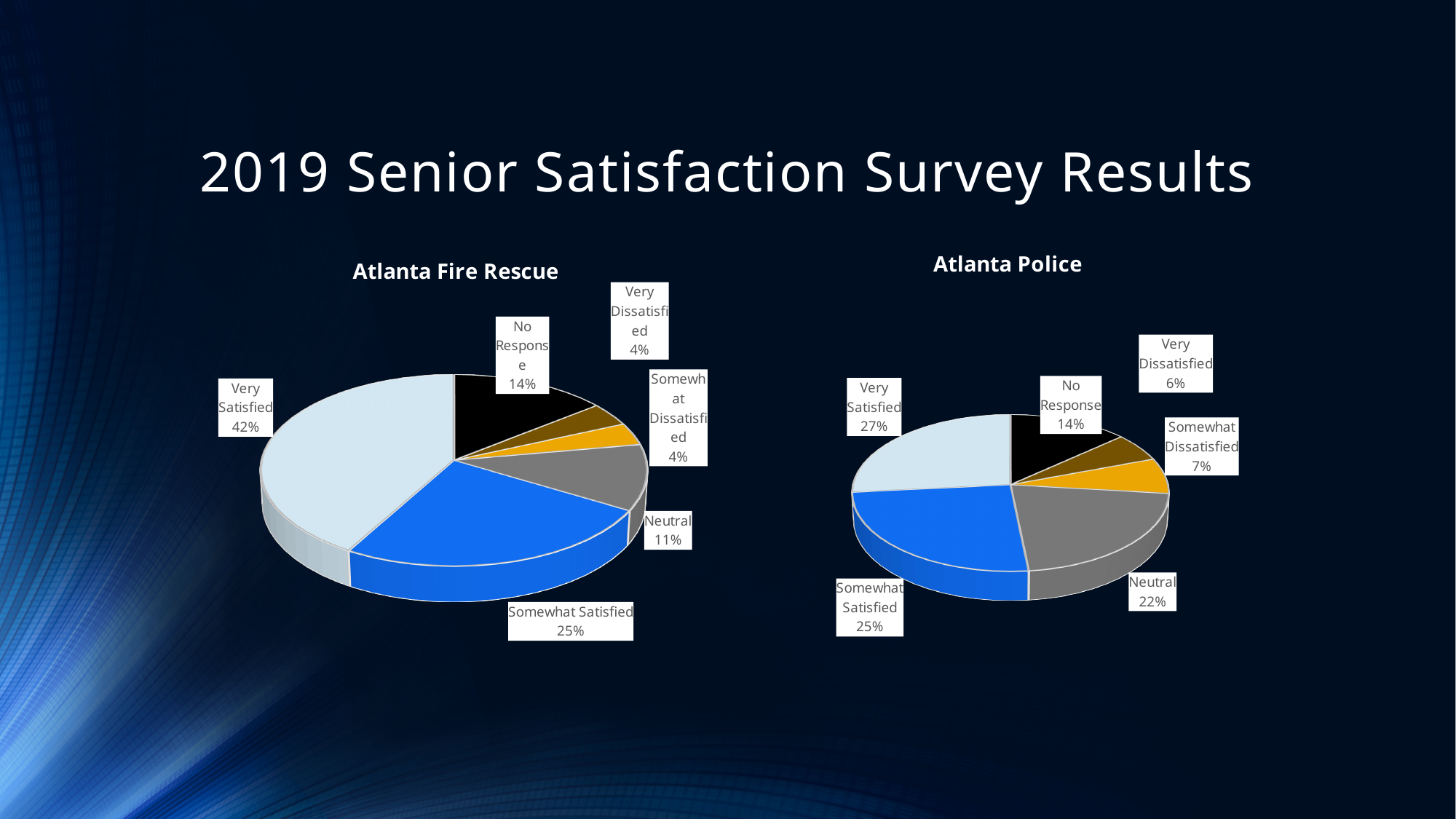
In the Atlanta Fire Rescue chart, what percentage of respondents gave No Response? 14% What is the title of the chart on the left side of the slide? Atlanta Fire Rescue In the Atlanta Fire Rescue chart, what percentage of respondents were Very Satisfied? 42% In the Atlanta Police chart, what percentage of respondents were Neutral? 22% In the Atlanta Police chart, which category has the smallest share? Very Dissatisfied What type of chart is used for the Atlanta Police results? Pie chart In the Atlanta Fire Rescue chart, which category has the largest share? Very Satisfied What is the difference between the Very Satisfied share in the Atlanta Fire Rescue chart and the Very Satisfied share in the Atlanta Police chart? 15% How many categories are shown in the Atlanta Fire Rescue chart? 6 Which chart shows a larger Neutral share, Atlanta Fire Rescue or Atlanta Police? Atlanta Police In the Atlanta Police chart, what percentage of respondents were Somewhat Dissatisfied? 7% In the Atlanta Police chart, what is the difference between the Neutral share and the Very Dissatisfied share? 16%